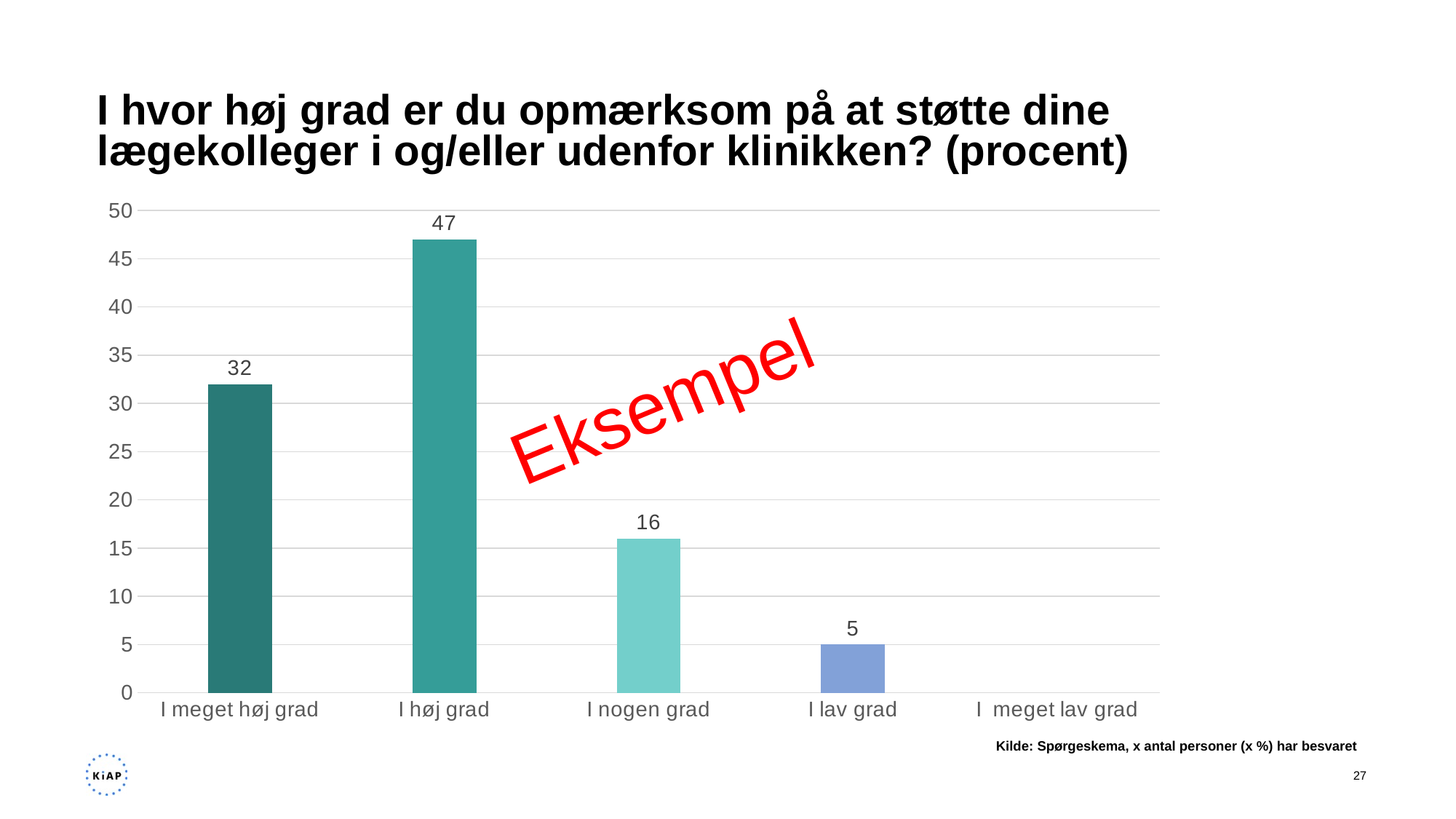
What kind of chart is shown on the slide? Bar chart Among the categories with a labelled bar, which has the lowest value? I lav grad What is the value for "I meget høj grad"? 32 What is the difference between the values for "I høj grad" and "I meget høj grad"? 15 What is the value for "I høj grad"? 47 What is the value for "I nogen grad"? 16 Which is larger, the value for "I nogen grad" or the value for "I lav grad"? I nogen grad How many categories are shown on the x axis? 5 What is the value for "I lav grad"? 5 Which category has the highest value? I høj grad What red word is written diagonally across the chart? Eksempel What is the difference between the values for "I meget høj grad" and "I nogen grad"? 16